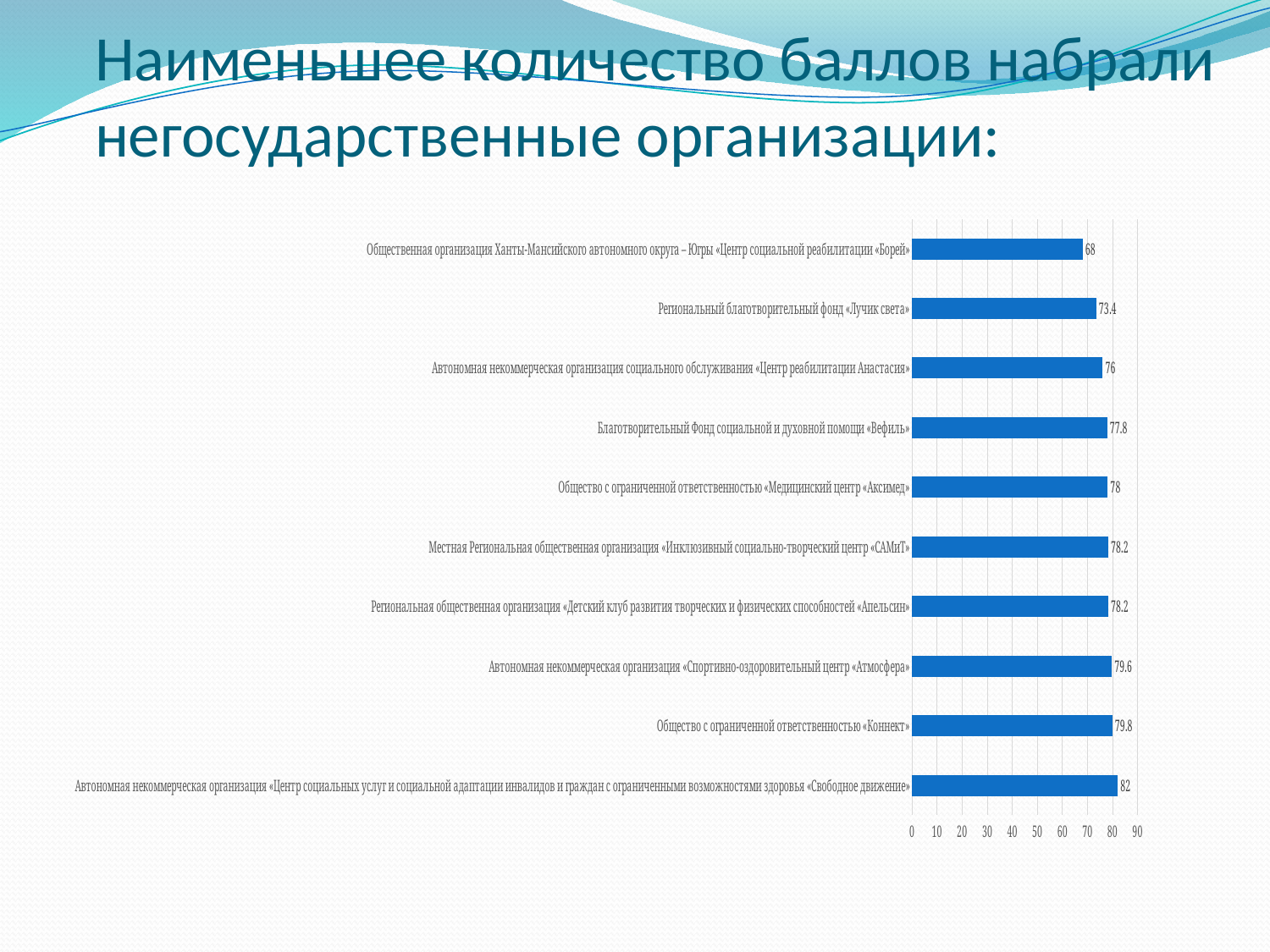
Which organization has the highest value in the chart? Автономная некоммерческая организация «Центр социальных услуг и социальной адаптации инвалидов и граждан с ограниченными возможностями здоровья «Свободное движение» Which has a larger value: «Центр реабилитации Анастасия» or «Вефиль»? «Вефиль» What is the highest tick value shown on the horizontal axis? 90 How many organizations (bars) are shown in the chart? 10 What is the difference between the value for «Свободное движение» and the value for «Борей»? 14 What is the difference between the value for «Лучик света» and the value for «Медицинский центр «Аксимед»? 4.6 What value is shown for «Спортивно-оздоровительный центр «Атмосфера»? 79.6 What type of chart is shown on the slide? bar chart What value is shown for Общество с ограниченной ответственностью «Коннект»? 79.8 What value is shown for «Центр социальной реабилитации «Борей»? 68 Which organization has the lowest value in the chart? Общественная организация Ханты-Мансийского автономного округа – Югры «Центр социальной реабилитации «Борей» What value is shown for Региональный благотворительный фонд «Лучик света»? 73.4